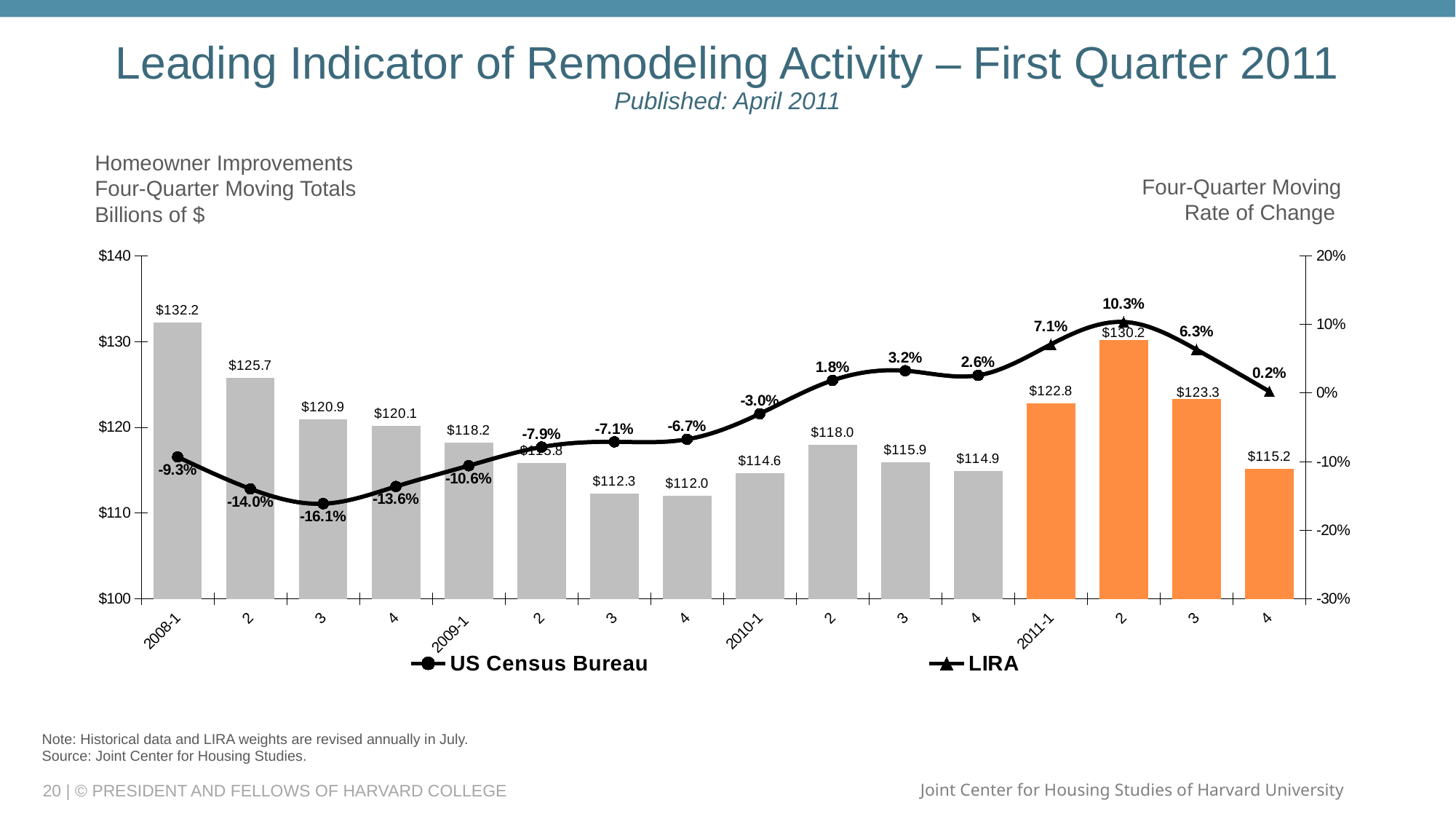
What is the difference between the four-quarter moving totals for 2011-2 and 2011-1? $7.4 What is the four-quarter moving rate of change for 2011-2? 10.3% Which is larger, the four-quarter moving total for 2010-2 or for 2010-3? 2010-2 Does the four-quarter moving rate of change rise or fall from 2008-3 to 2011-2? Rise How many quarters are shown on the x axis? 16 Which quarter has the highest four-quarter moving total? 2008-1 Which quarter has the lowest four-quarter moving rate of change? 2008-3 What kind of chart is used to show the four-quarter moving totals? Bar chart How many series does the legend list? 2 Which quarter has the lowest four-quarter moving total? 2009-4 What is the four-quarter moving total for 2008-1? $132.2 What is the four-quarter moving total for 2011-4? $115.2